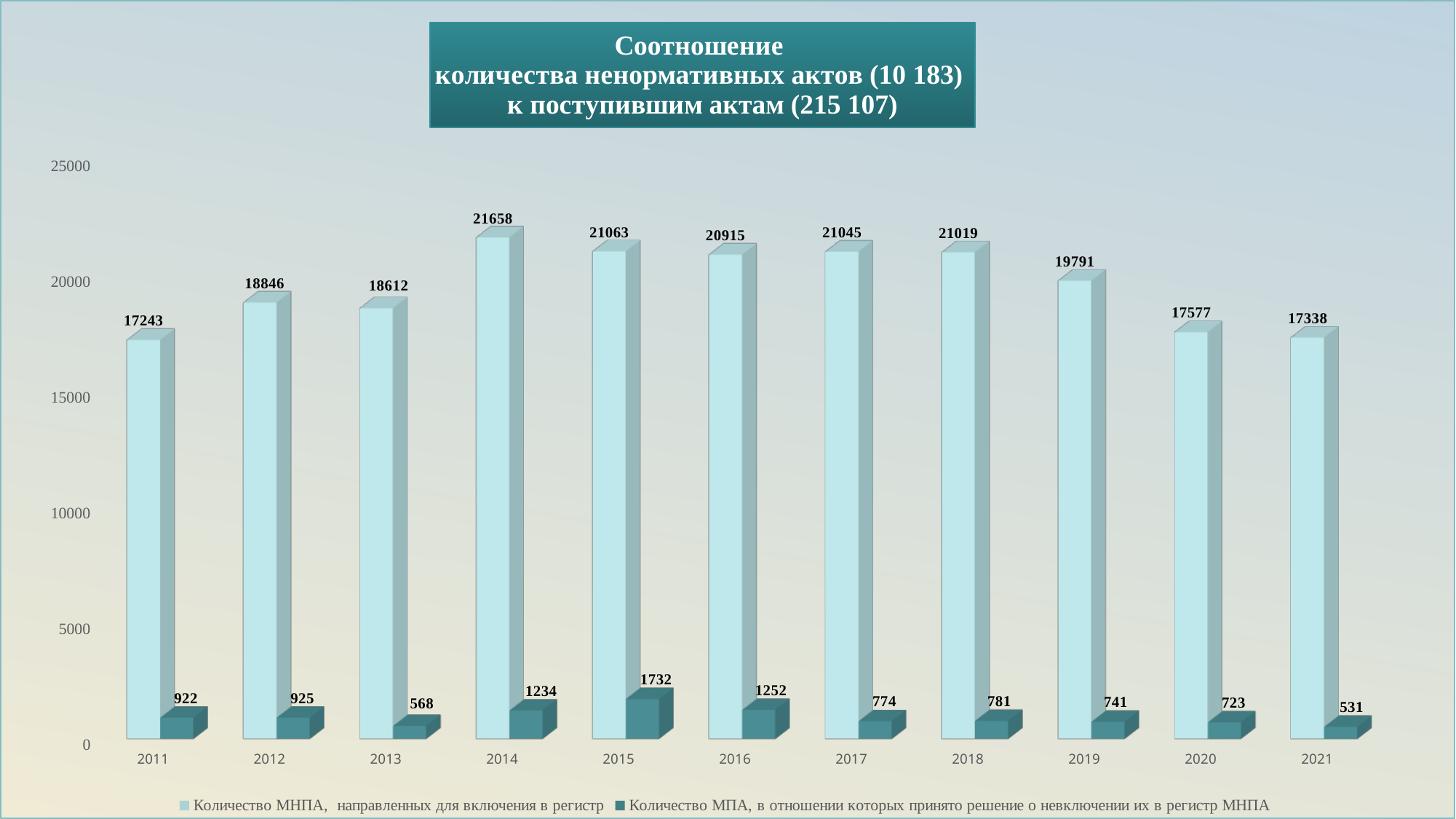
In which year is 'Количество МНПА, направленных для включения в регистр' the highest? 2014 In which year is 'Количество МПА, в отношении которых принято решение о невключении их в регистр МНПА' the lowest? 2021 How many years are shown on the x axis of the chart? 11 What is the value of 'Количество МПА, в отношении которых принято решение о невключении их в регистр МНПА' for 2015? 1732 What is the difference between the 'Количество МПА, в отношении которых принято решение о невключении их в регистр МНПА' values for 2015 and 2013? 1164 Is the value for 'Количество МНПА, направленных для включения в регистр' in 2019 greater or less than 15000? greater What is the value of 'Количество МНПА, направленных для включения в регистр' for 2014? 21658 What is the difference between the 'Количество МНПА, направленных для включения в регистр' values for 2014 and 2021? 4320 Which year has the larger value for 'Количество МНПА, направленных для включения в регистр': 2012 or 2013? 2012 How many series does the legend list? 2 In which year is 'Количество МНПА, направленных для включения в регистр' the lowest? 2011 What kind of chart is shown on the slide? bar chart